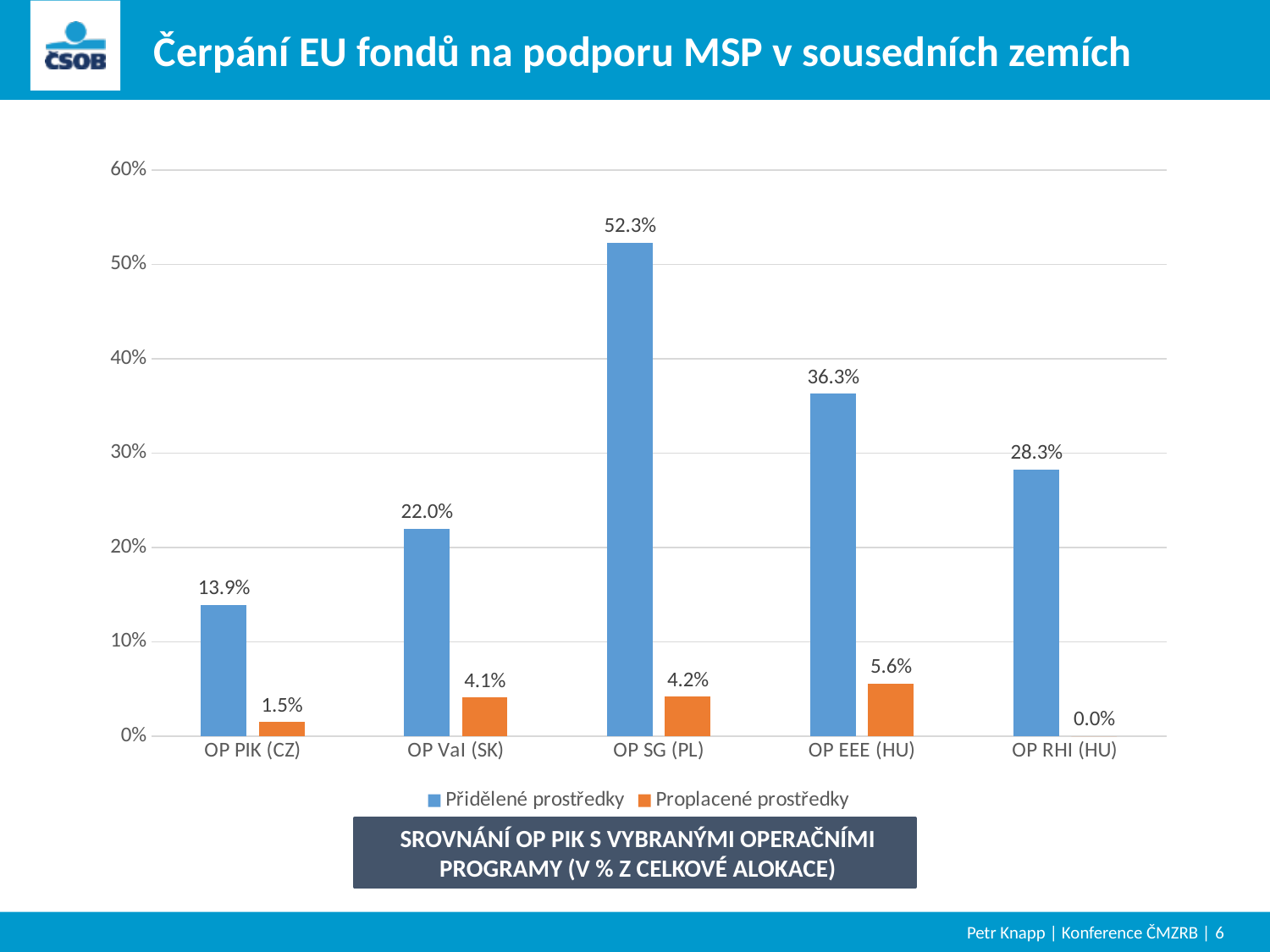
Which category has the lowest value for Přidělené prostředky? OP PIK (CZ) Which is larger: Přidělené prostředky for OP Val (SK) or for OP RHI (HU)? OP RHI (HU) What is the value of Přidělené prostředky for OP SG (PL)? 52.3% What is the value of Proplacené prostředky for OP PIK (CZ)? 1.5% What is the difference between Přidělené prostředky for OP SG (PL) and OP EEE (HU)? 16.0% Which category has the highest value for Přidělené prostředky? OP SG (PL) How many series does the legend list? 2 Is the value of Přidělené prostředky for OP EEE (HU) greater or less than 40%? less What kind of chart is shown on the slide? bar chart Which colour represents Proplacené prostředky in the chart? orange What is the value of Proplacené prostředky for OP EEE (HU)? 5.6% How many categories are shown on the x axis? 5